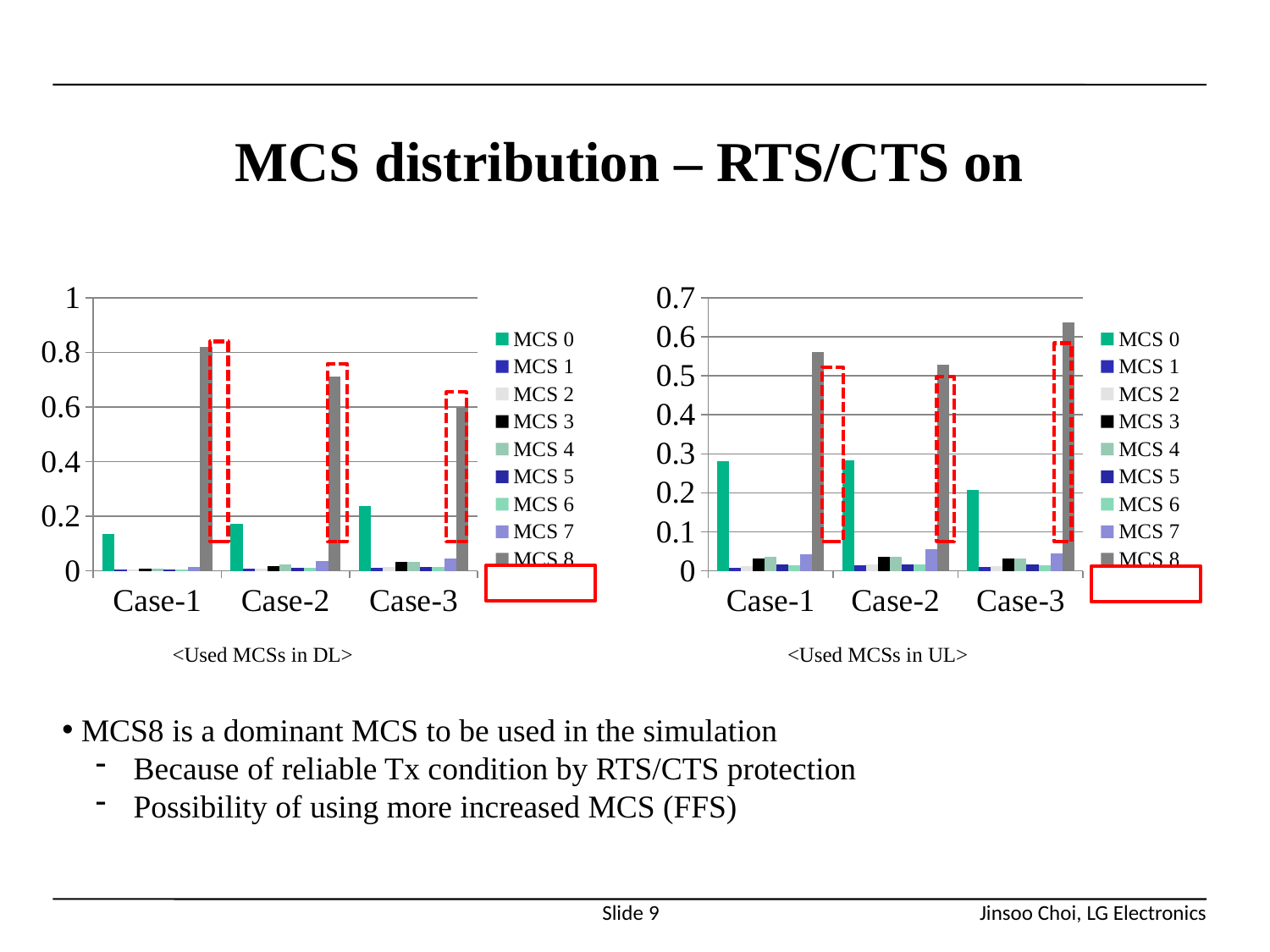
Which series is highlighted with red dashed boxes in both charts? MCS 8 In the <Used MCSs in DL> chart, which case has the highest MCS 8 bar? Case-1 In the <Used MCSs in DL> chart, does the MCS 8 value rise or fall from Case-1 to Case-3? fall In the <Used MCSs in DL> chart, which is larger: the MCS 0 value for Case-1 or for Case-3? Case-3 In the <Used MCSs in UL> chart, is the MCS 8 value for Case-1 greater or less than 0.5? greater How many series does the legend of the <Used MCSs in UL> chart list? 9 In the <Used MCSs in DL> chart, is the MCS 8 value for Case-2 greater or less than 0.6? greater In the <Used MCSs in DL> chart, is the MCS 0 value for Case-3 greater or less than 0.4? less In the <Used MCSs in UL> chart, which case has the highest MCS 8 bar? Case-3 How many categories are shown on the x axis of the <Used MCSs in DL> chart? 3 What kind of chart is the <Used MCSs in DL> chart on the left? bar chart